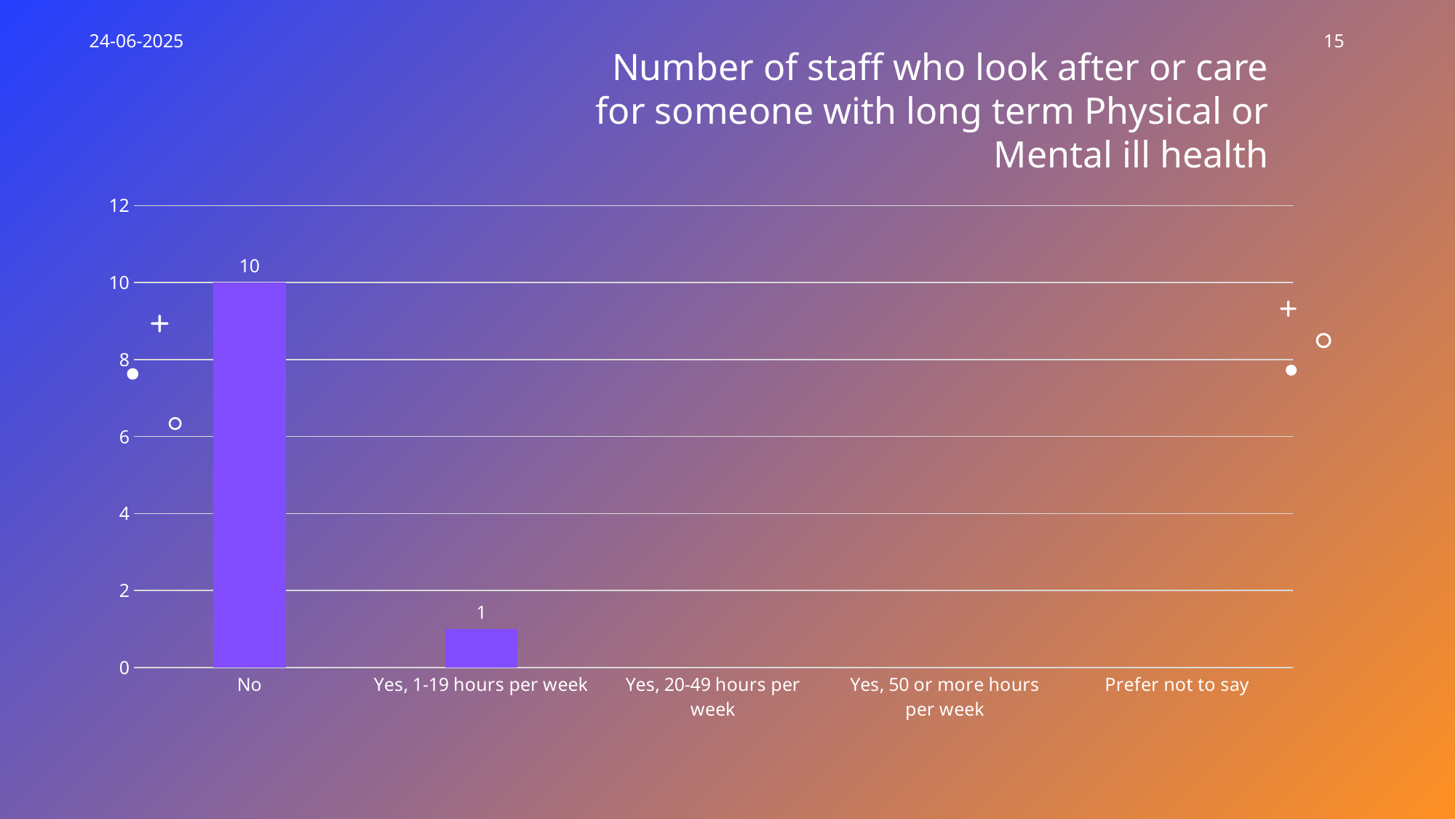
What is the maximum value shown on the y axis? 12 Which category has the highest value? No Which is larger, the value for "No" or the value for "Yes, 1-19 hours per week"? No What is the title of the chart? Number of staff who look after or care for someone with long term Physical or Mental ill health Is the value for "Yes, 1-19 hours per week" greater or less than 2? less How many categories have a visible bar? 2 What is the difference between the values for "No" and "Yes, 1-19 hours per week"? 9 What is the value for the "No" category? 10 What is the value for "Yes, 1-19 hours per week"? 1 How many categories are shown on the x axis? 5 What kind of chart is shown on the slide? Bar chart Is the value for "No" greater or less than 8? greater